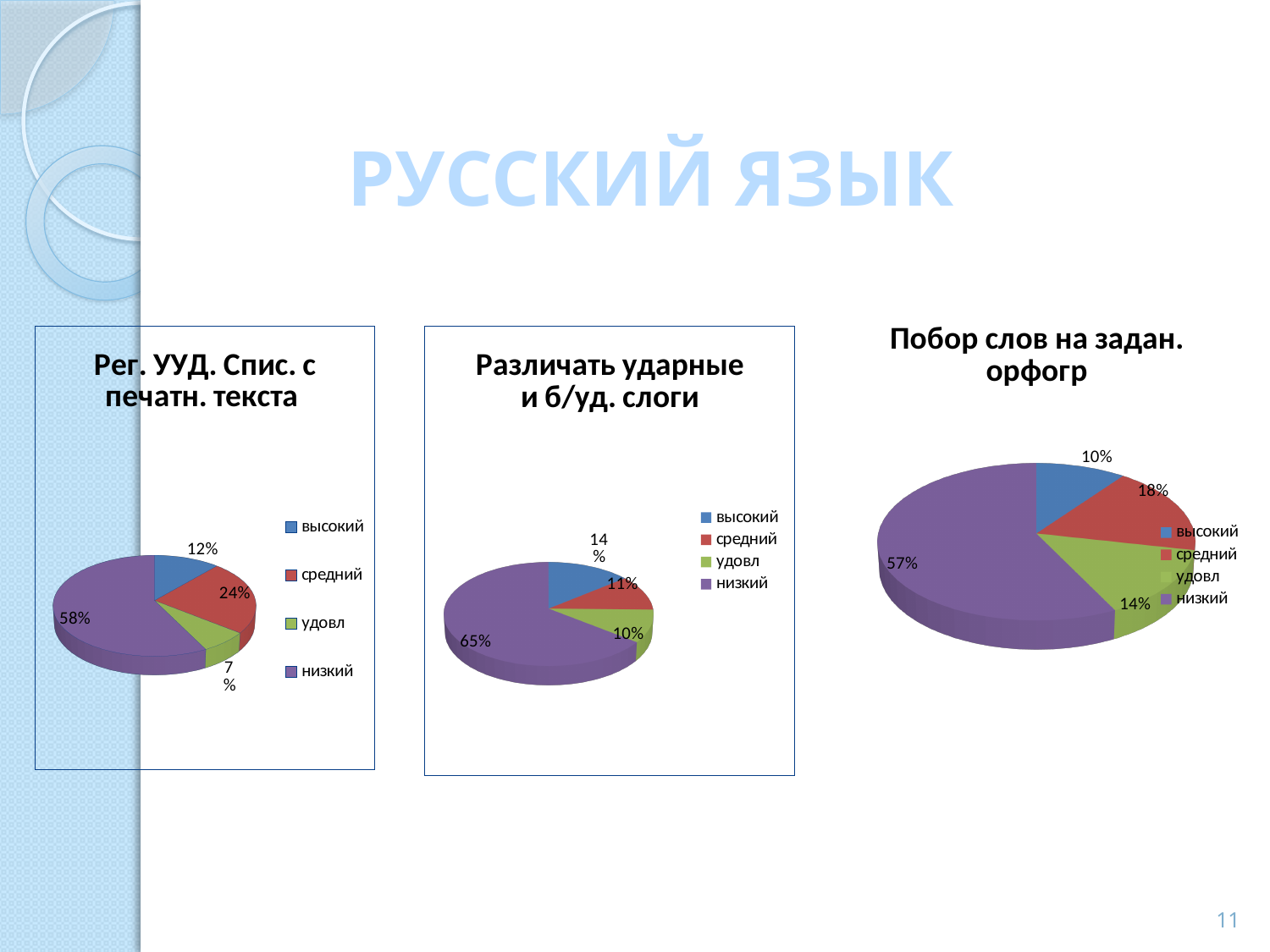
In the chart titled "Побор слов на задан. орфогр", what share is labelled for низкий? 57% In the chart titled "Различать ударные и б/уд. слоги", which category has the largest slice? низкий In the chart titled "Побор слов на задан. орфогр", what share is labelled for средний? 18% In the chart titled "Различать ударные и б/уд. слоги", what share is labelled for низкий? 65% In the chart titled "Побор слов на задан. орфогр", which is larger, the slice for удовл or the slice for высокий? удовл In the chart titled "Рег. УУД. Спис. с печатн. текста", what share is labelled for средний? 24% What kind of chart is the chart titled "Побор слов на задан. орфогр"? pie chart In the chart titled "Рег. УУД. Спис. с печатн. текста", which category has the smallest slice? удовл In the chart titled "Рег. УУД. Спис. с печатн. текста", what is the difference between the shares for низкий and средний? 34% In the chart titled "Различать ударные и б/уд. слоги", what share is labelled for высокий? 14% How many categories does the legend list in the chart titled "Различать ударные и б/уд. слоги"? 4 In the chart titled "Рег. УУД. Спис. с печатн. текста", what share is labelled for низкий? 58%